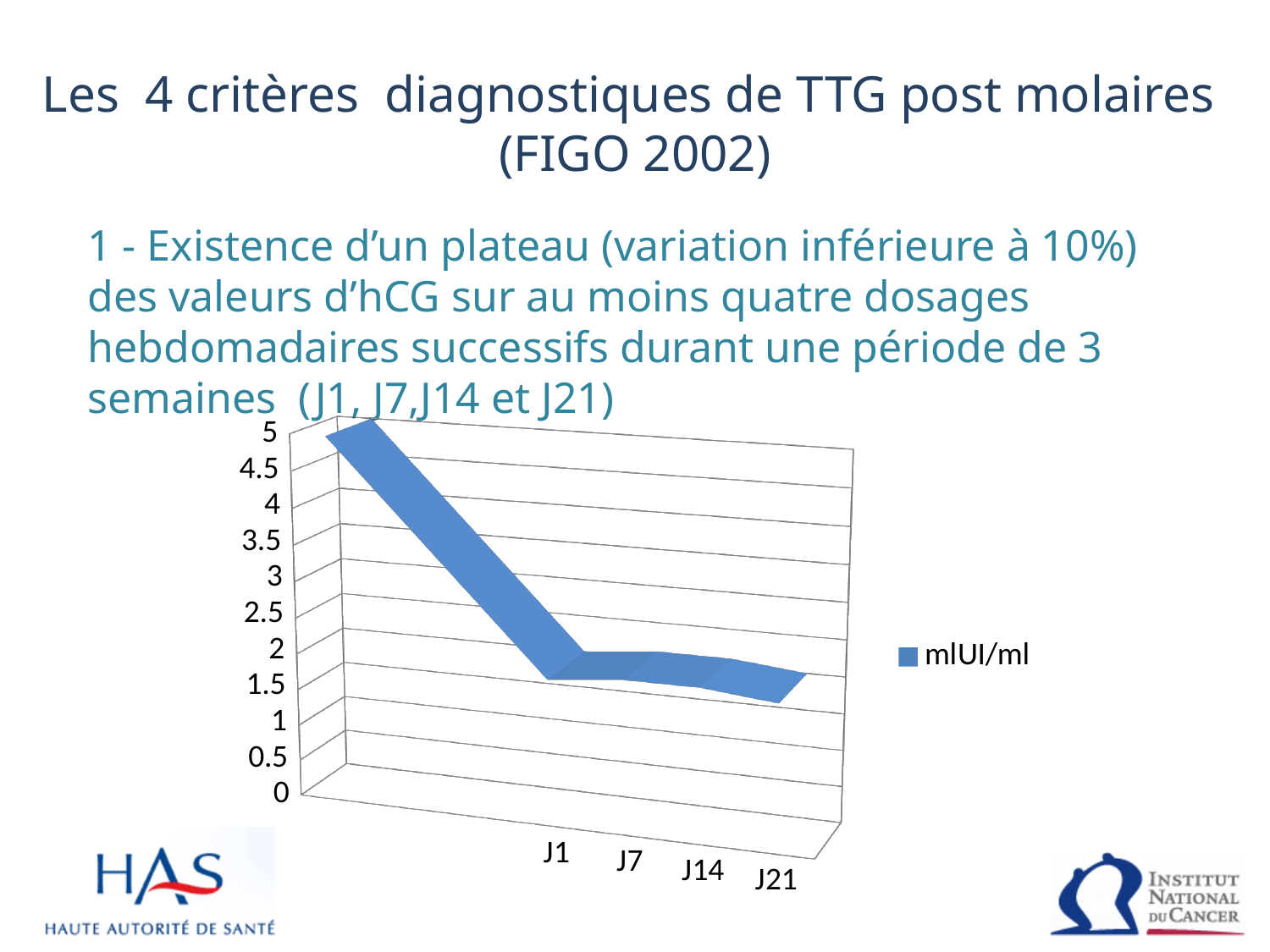
Is the value for J7 greater or less than 3? less Is the value for J14 greater or less than 4? less How many series does the chart legend list? 1 What kind of chart is shown on the slide? line chart Is the value for J1 greater or less than 4? less What are the category labels on the x axis of the chart? J1, J7, J14, J21 What is the name of the series shown in the chart legend? mlUI/ml